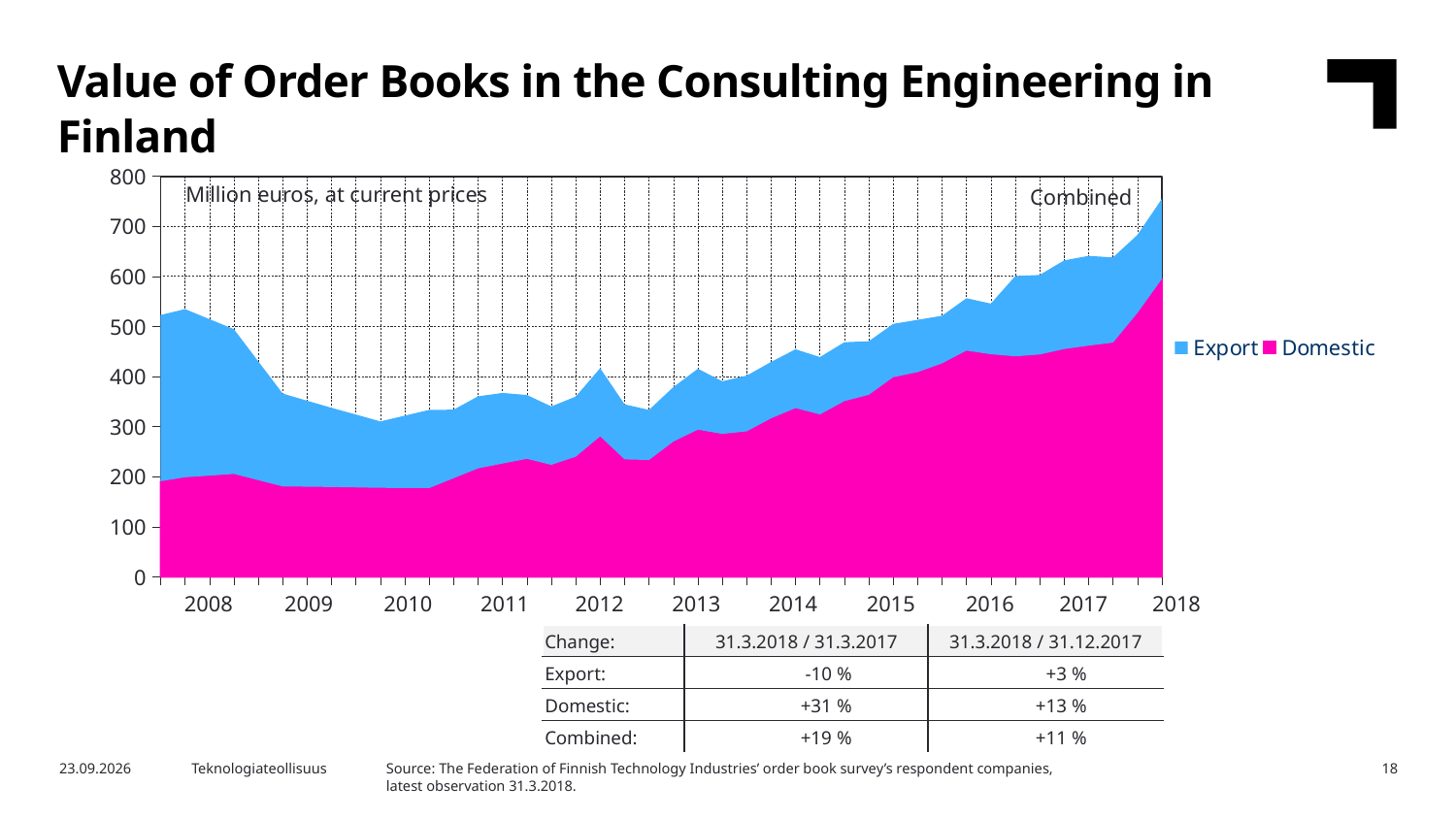
Which is larger, the Domestic value at 2008 or the Domestic value at 2018? 2018 In which year does the Combined value reach its highest point? 2018 Is the Combined value at 2010 greater or less than 400? less What unit is stated in the chart's top-left label? Million euros, at current prices Is the Domestic value at 2018 greater or less than 500? greater Is the Combined value at 2018 greater or less than 700? greater Which two series are listed in the chart's legend? Export and Domestic How many year labels appear on the x axis? 11 How many series does the chart's legend list? 2 Does the Domestic value rise or fall between 2013 and 2018? Rise What kind of chart is shown on the slide? Stacked area chart